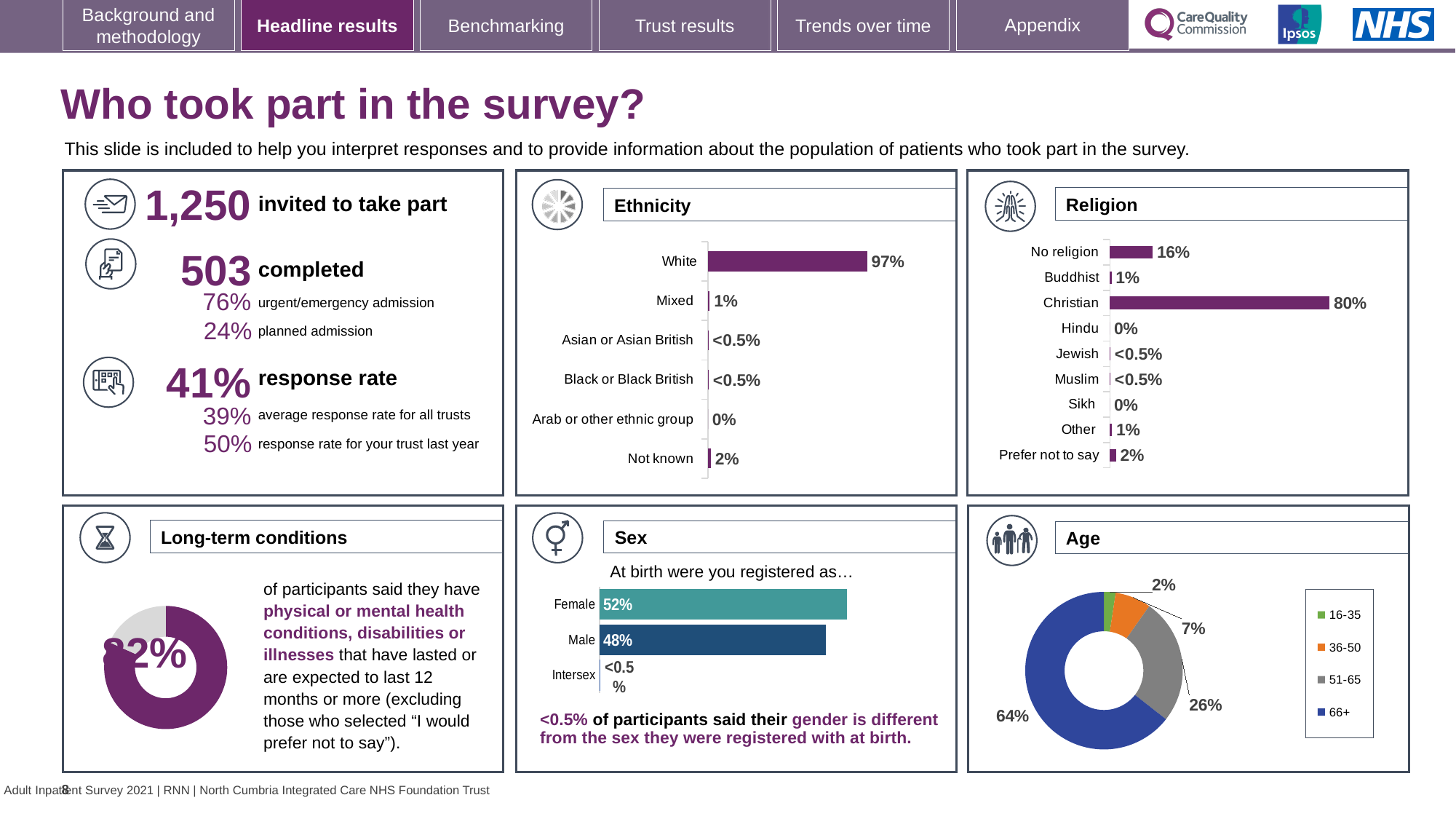
In the Sex chart, which is larger, Female or Male? Female In the Religion chart, what percentage of participants were Christian? 80% In the Age chart, how many age groups does the legend list? 4 In the Religion chart, what is the difference between the Christian and No religion percentages? 64% What kind of chart is the Age chart? Doughnut chart In the Ethnicity chart, which ethnic group has the highest percentage? White In the Age chart, what share of participants were aged 66+? 64% In the Religion chart, how many religion categories are listed? 9 In the Ethnicity chart, what is the value for Not known? 2% In the Religion chart, what is the value for Prefer not to say? 2% In the Ethnicity chart, what percentage of participants were White? 97% In the Sex chart, what percentage of participants were registered as Female at birth? 52%